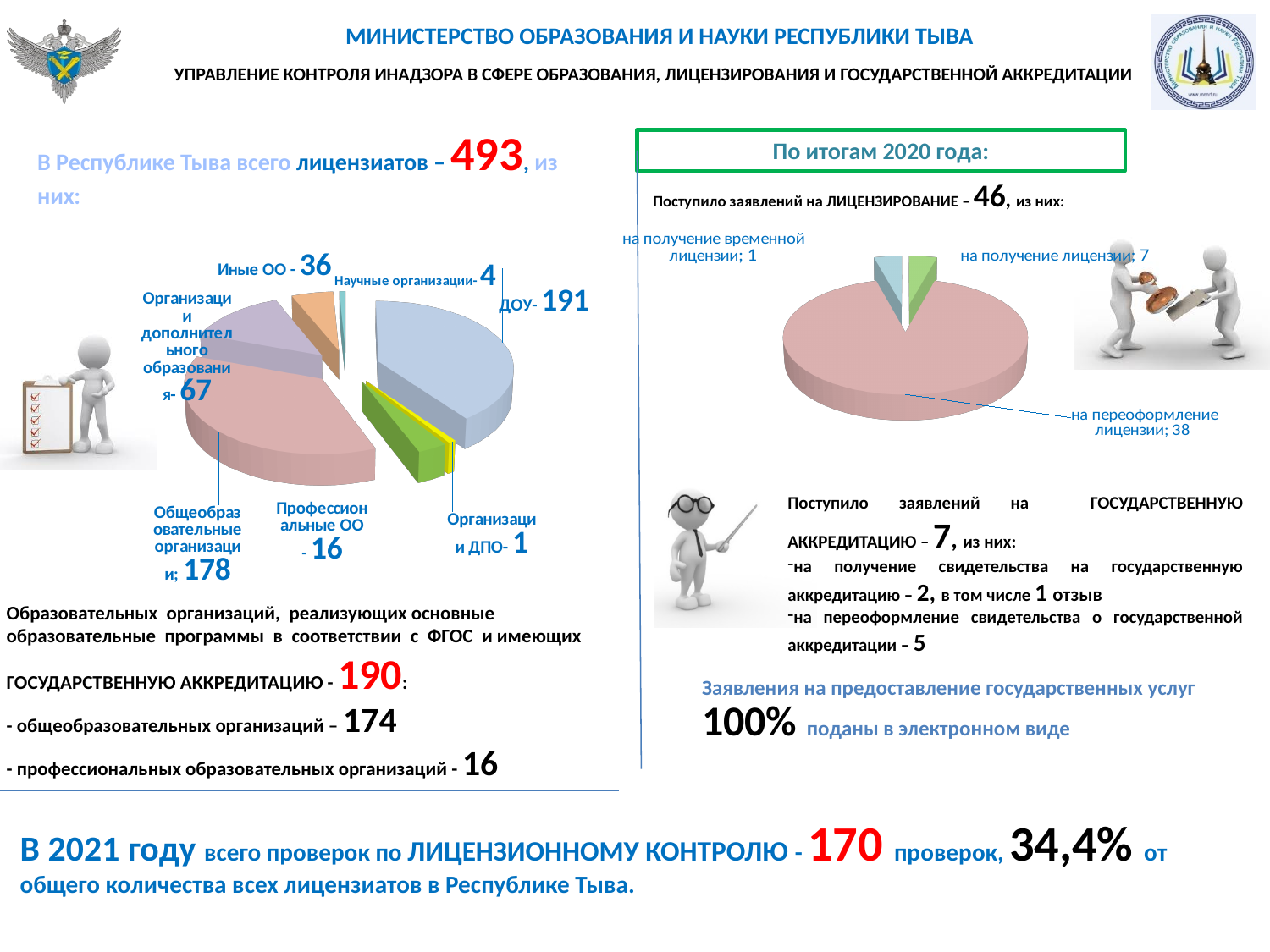
On the left pie chart of licensees, what is the value for Общеобразовательные организации? 178 What type of chart is used on the right to show licensing applications? Pie chart On the left pie chart of licensees, what is the difference between ДОУ and Общеобразовательные организации? 13 On the right pie chart of licensing applications, which category has the smallest value? на получение временной лицензии On the left pie chart of licensees, what is the value for ДОУ? 191 On the left pie chart of licensees, which is larger: Организации дополнительного образования or Иные ОО? Организации дополнительного образования How many categories does the left pie chart of licensees show? 7 On the left pie chart of licensees, what is the value for Иные ОО? 36 On the left pie chart of licensees, which category has the largest value? ДОУ On the right pie chart of licensing applications, what is the value for на переоформление лицензии? 38 On the left pie chart of licensees, which category has the smallest value? Организации ДПО On the right pie chart of licensing applications, what is the difference between на получение лицензии and на получение временной лицензии? 6